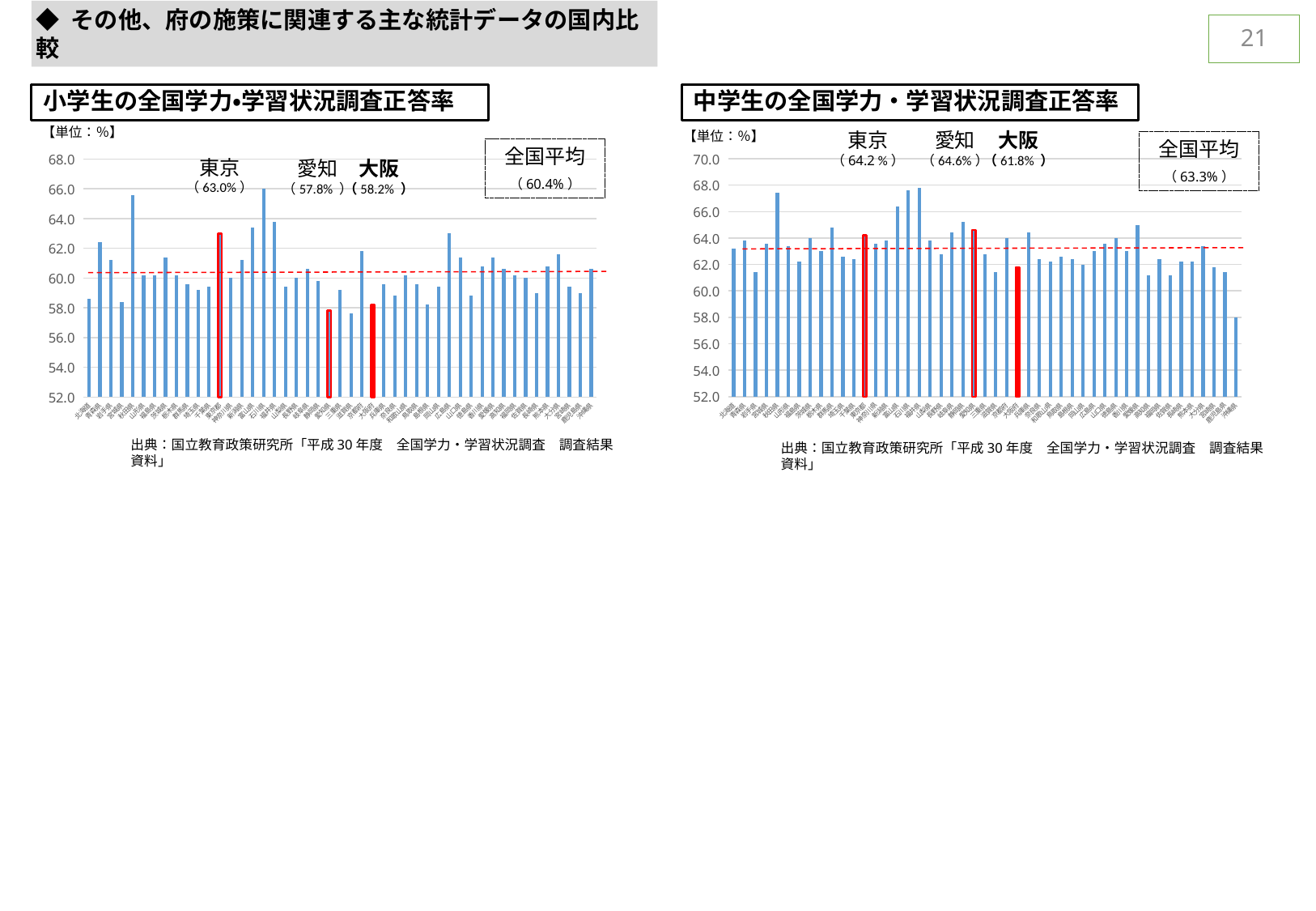
In the 小学生の全国学力•学習状況調査正答率 chart on the left, what is the value for 愛知? 57.8% In the 小学生の全国学力•学習状況調査正答率 chart on the left, what is the value for 大阪? 58.2% In the 中学生の全国学力・学習状況調査正答率 chart on the right, what is the difference between the values for 愛知 and 大阪? 2.8% In the 中学生の全国学力・学習状況調査正答率 chart on the right, what is the value for 大阪? 61.8% In the 中学生の全国学力・学習状況調査正答率 chart on the right, what is the 全国平均 (national average) shown? 63.3% In the 中学生の全国学力・学習状況調査正答率 chart on the right, which is larger, the value for 愛知 or the value for 東京? 愛知 What kind of chart is the 小学生の全国学力•学習状況調査正答率 chart on the left? bar chart In the 小学生の全国学力•学習状況調査正答率 chart on the left, what is the value for 東京? 63.0% In the 小学生の全国学力•学習状況調査正答率 chart on the left, what is the difference between the values for 東京 and 大阪? 4.8% In the 小学生の全国学力•学習状況調査正答率 chart on the left, what is the 全国平均 (national average) shown? 60.4% In the 中学生の全国学力・学習状況調査正答率 chart on the right, what is the value for 東京? 64.2% In the 小学生の全国学力•学習状況調査正答率 chart on the left, is the value for 大阪 greater or less than 60.0? less